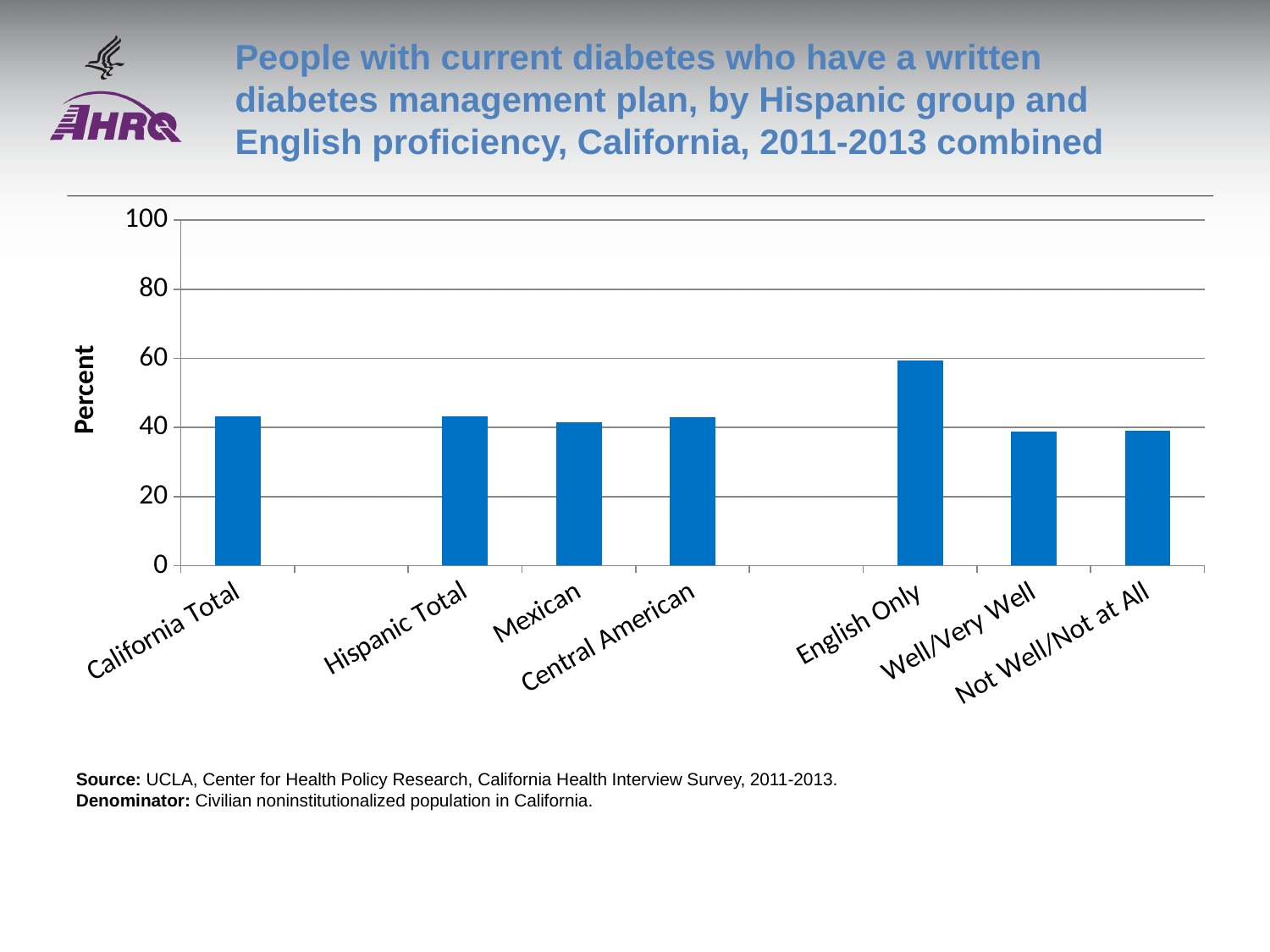
Is the value for English Only greater or less than 40? greater Is the value for California Total greater or less than 60? less Which category has the highest value in the chart? English Only What kind of chart is shown on the slide? bar chart What is the label on the vertical axis of the chart? Percent Which is larger, the value for Well/Very Well or the value for English Only? English Only Is the value for English Only greater or less than 80? less How many categories (bars) are plotted in the chart? 7 Which is larger, the value for English Only or the value for Hispanic Total? English Only What is the highest value shown on the vertical axis of the chart? 100